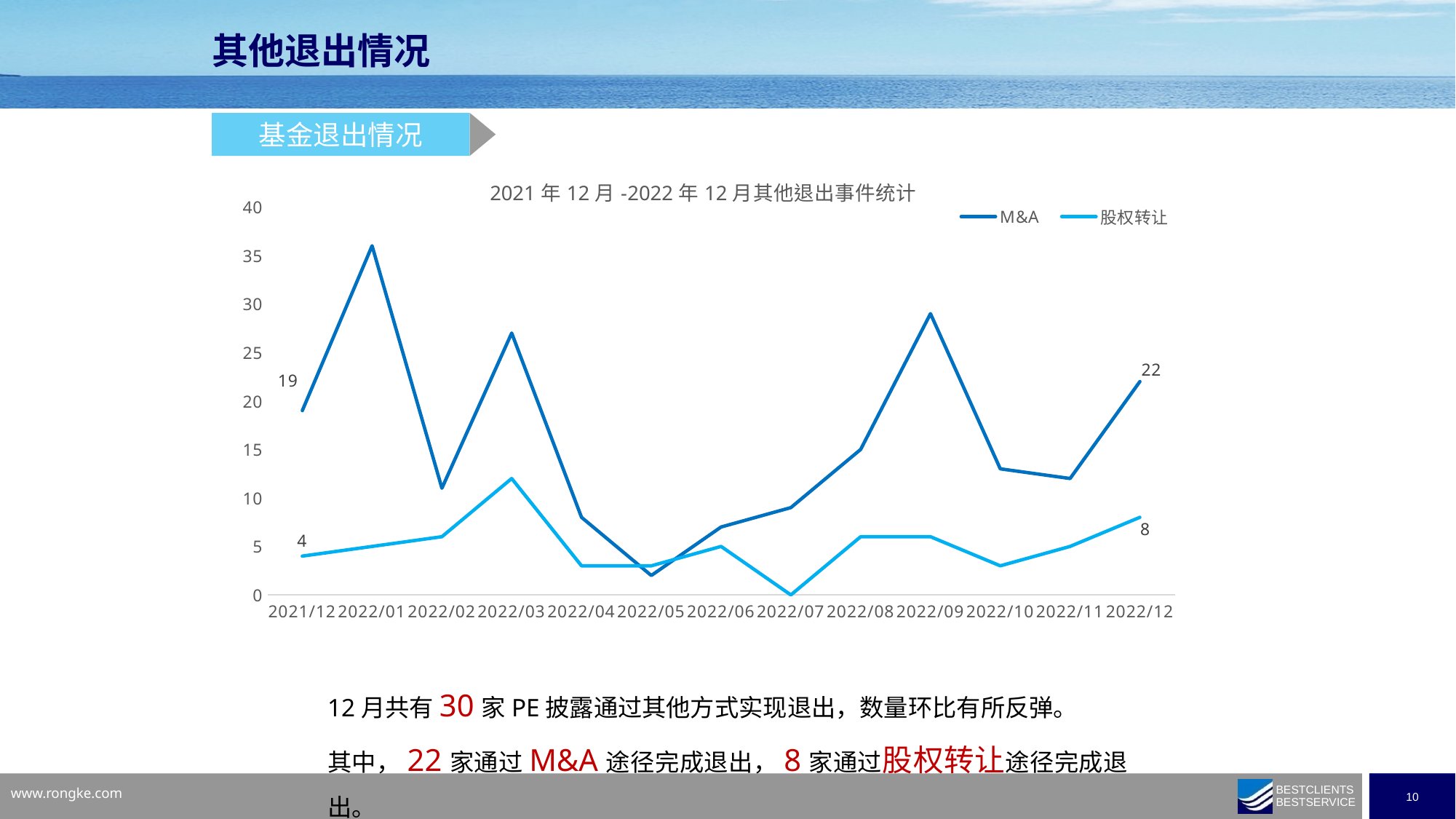
What is the title of the chart? 2021年12月-2022年12月其他退出事件统计 Is the M&A value for 2022/09 greater or less than 25? greater Which series has the larger value in 2021/12, M&A or 股权转让? M&A How many months are shown on the x axis of the chart? 13 In which month does the 股权转让 series reach its lowest value? 2022/07 In which month does the M&A series reach its highest value? 2022/01 What is the M&A value for 2022/12? 22 How many series does the chart legend list? 2 What is the difference between the M&A and 股权转让 values in 2022/12? 14 What is the M&A value for 2021/12? 19 What is the 股权转让 value for 2022/12? 8 What type of chart is shown on the slide? Line chart